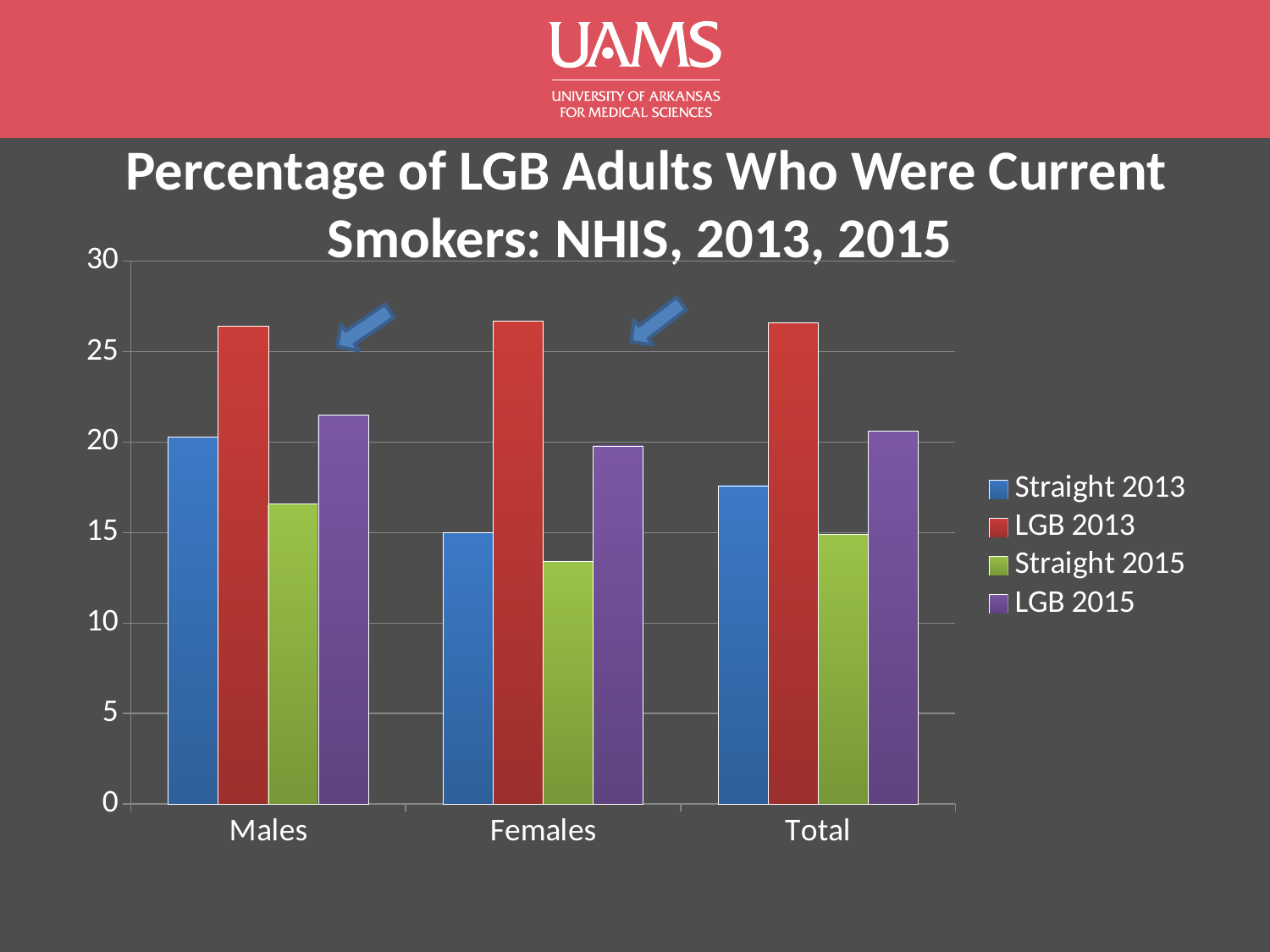
Which series has the lowest value in the Females category? Straight 2015 Is the value for LGB 2013 in the Males category greater or less than 25? greater Which is larger: Straight 2013 for Males or Straight 2013 for Females? Straight 2013 for Males Which series has the lowest value in the Total category? Straight 2015 How many series does the legend list? 4 How many categories are shown on the x axis? 3 What is the title of the chart? Percentage of LGB Adults Who Were Current Smokers: NHIS, 2013, 2015 Which series has the highest value in the Males category? LGB 2013 Is the value for Straight 2013 in the Females category greater or less than 20? less Is the value for Straight 2015 in the Females category greater or less than 15? less Which is larger: LGB 2015 for Males or Straight 2015 for Males? LGB 2015 for Males What kind of chart is shown on the slide? bar chart